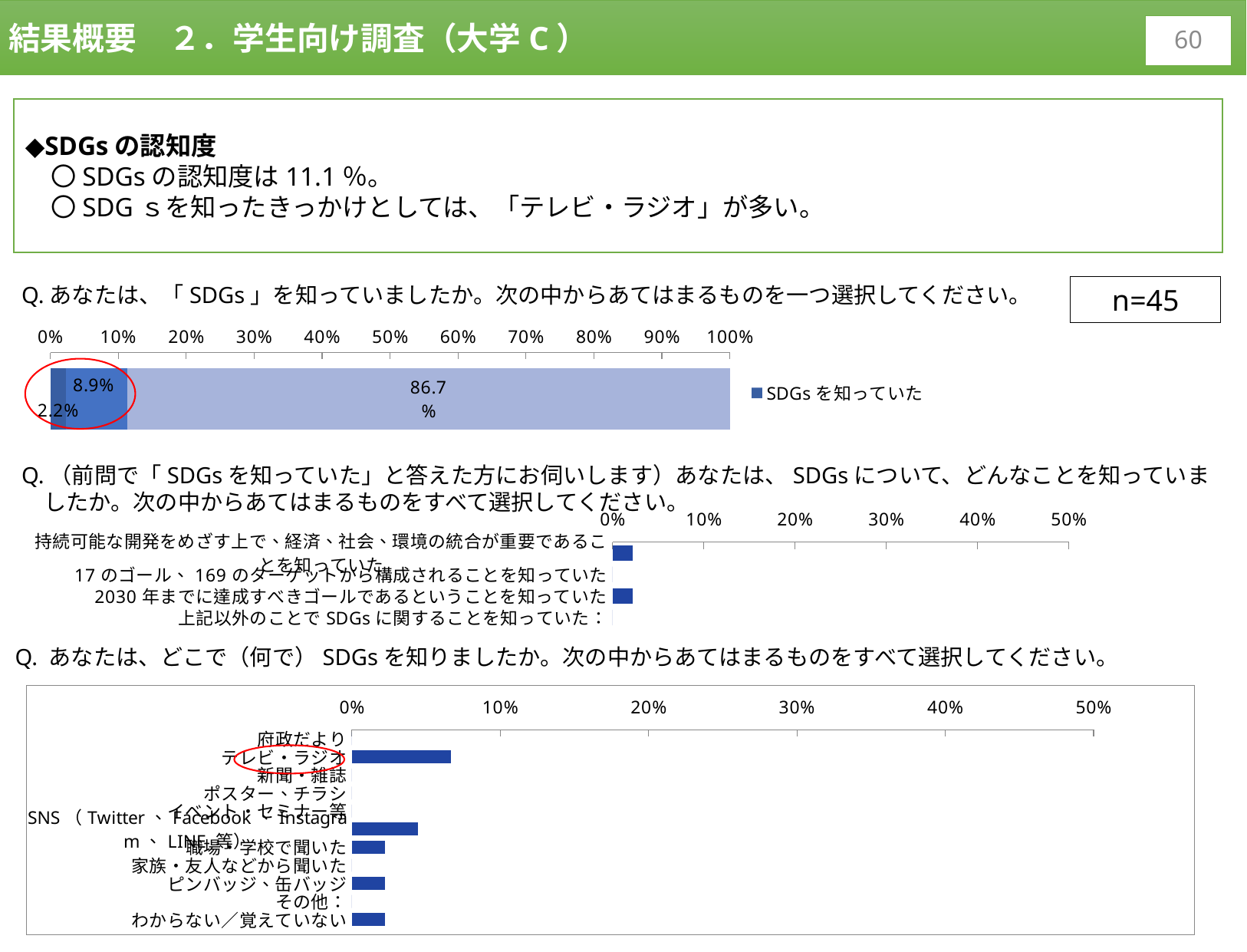
How many categories are listed in the middle chart (what they knew about SDGs)? 4 In the bottom chart, is the value for テレビ・ラジオ greater or less than 10%? less In the bottom chart, which is larger: テレビ・ラジオ or SNS（Twitter、Facebook、Instagram、LINE等）? テレビ・ラジオ In the top stacked bar chart, what is the combined value of the 2.2% and 8.9% segments? 11.1% What kind of chart is the top chart on the slide? bar chart How many categories are listed in the bottom chart? 11 In the bottom chart (where did you learn about SDGs), which category has the highest value? テレビ・ラジオ In the top stacked bar chart, what is the value of the smallest segment? 2.2% In the top chart, what is the legend entry shown? SDGsを知っていた In the top stacked bar chart, what is the value of the largest segment? 86.7% In the top stacked bar chart, what is the difference between the 86.7% segment and the 8.9% segment? 77.8% In the top stacked bar chart, what is the value of the middle segment? 8.9%